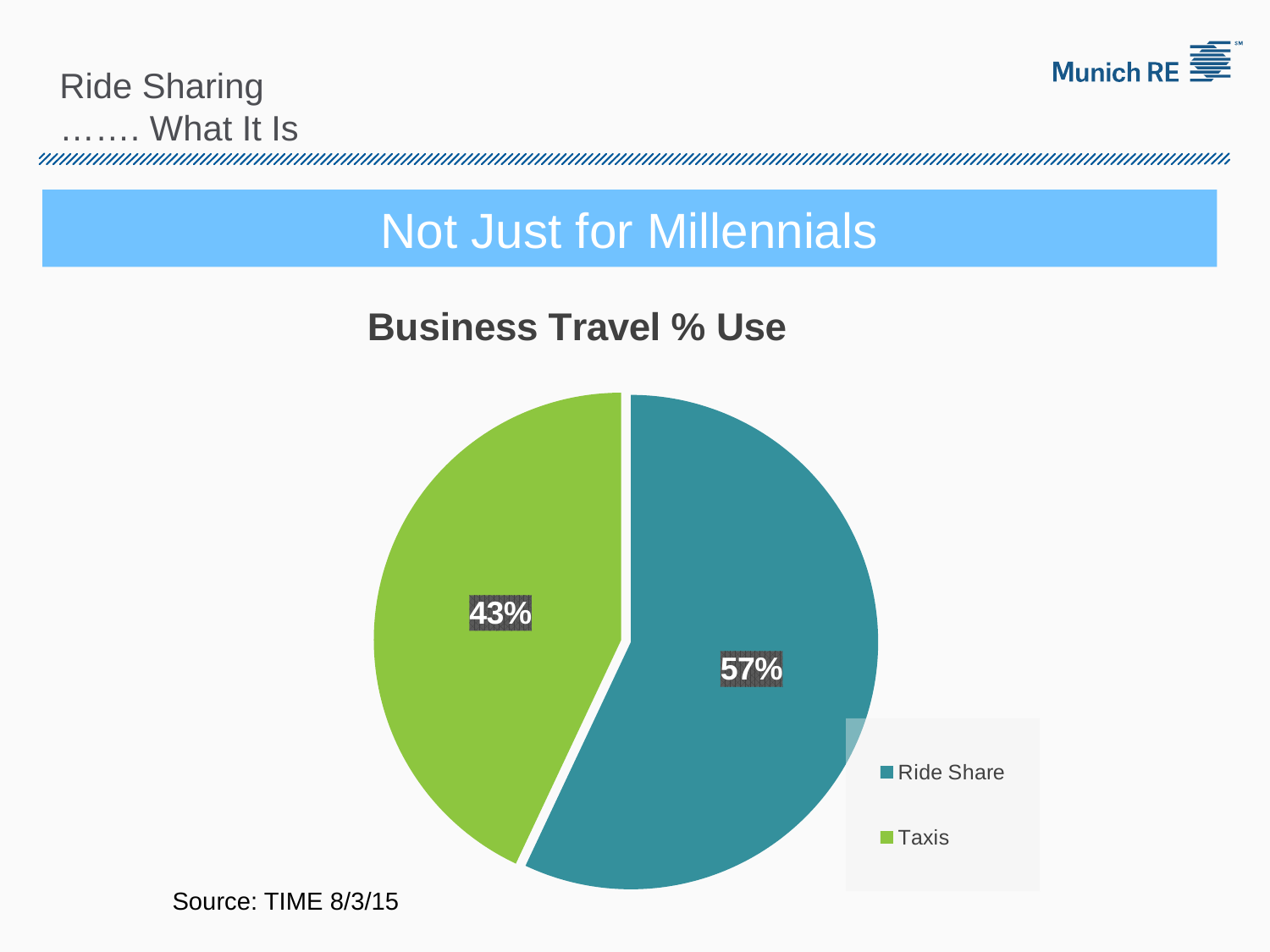
What type of chart is shown on the slide? pie chart What share of the pie does the Ride Share slice represent? 57% What is the title of the chart? Business Travel % Use How many slices does the pie chart have? 2 How many entries does the legend list? 2 What colour is the Taxis slice? green Which category has the largest share of the pie? Ride Share What percentage of business travel use is Taxis? 43% Which is larger, the share for Ride Share or the share for Taxis? Ride Share What is the difference in percentage points between Ride Share and Taxis? 14 What percentage of business travel use is Ride Share? 57% Which category has the smallest share of the pie? Taxis